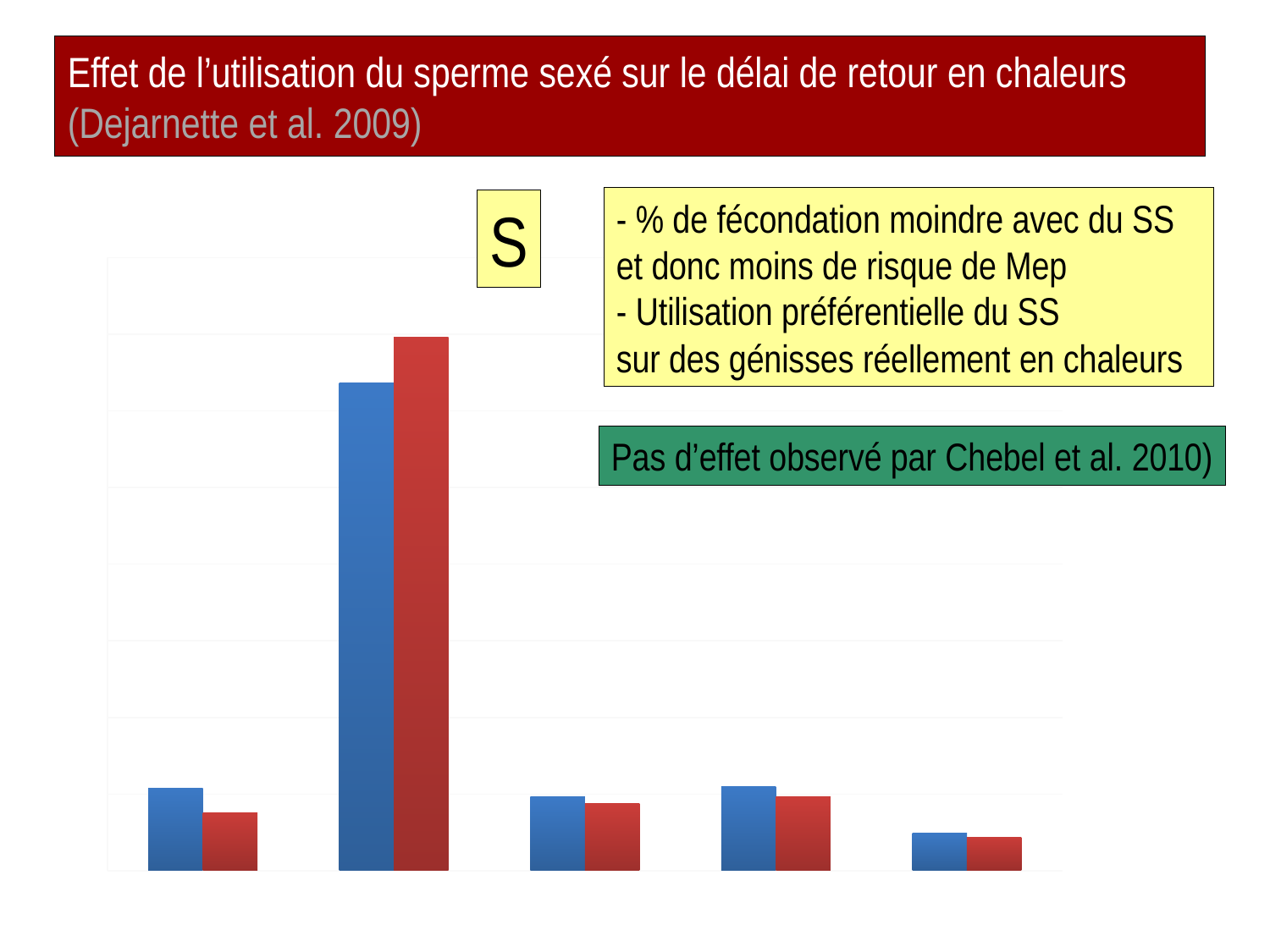
What kind of chart is shown on the slide? bar chart Which group of bars, counted from the left, is the shortest on the chart? the fifth group In the second group from the left, which bar is taller, the blue one or the red one? the red one What two colours are used for the bars on the chart? blue and red Does the chart display a legend? No In the first group from the left, which bar is taller, the blue one or the red one? the blue one Which group of bars, counted from the left, is the tallest on the chart? the second group How many bars are in each group on the chart? 2 How many groups of bars does the chart show? 5 In the fourth group from the left, which bar is taller, the blue one or the red one? the blue one